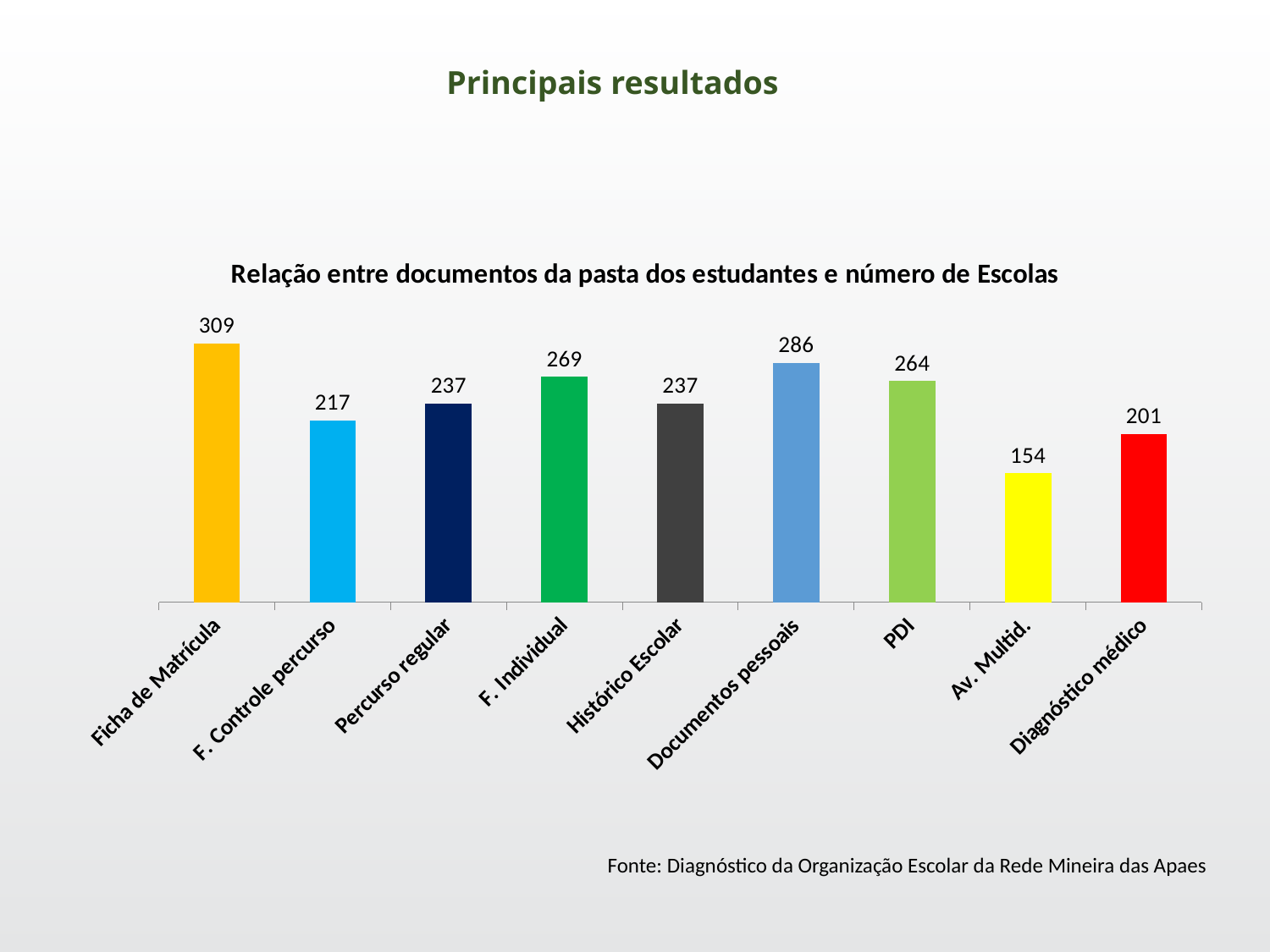
What is the difference between the values for Ficha de Matrícula and Av. Multid.? 155 What is the title of the chart? Relação entre documentos da pasta dos estudantes e número de Escolas How many categories are shown on the x axis? 9 What kind of chart is shown? Bar chart What is the value for Av. Multid.? 154 What is the value for Diagnóstico médico? 201 Which category has the highest value? Ficha de Matrícula What is the value for Ficha de Matrícula? 309 What is the difference between the values for Documentos pessoais and PDI? 22 What is the value for Documentos pessoais? 286 Which is larger, the value for F. Individual or the value for F. Controle percurso? F. Individual Which category has the lowest value? Av. Multid.